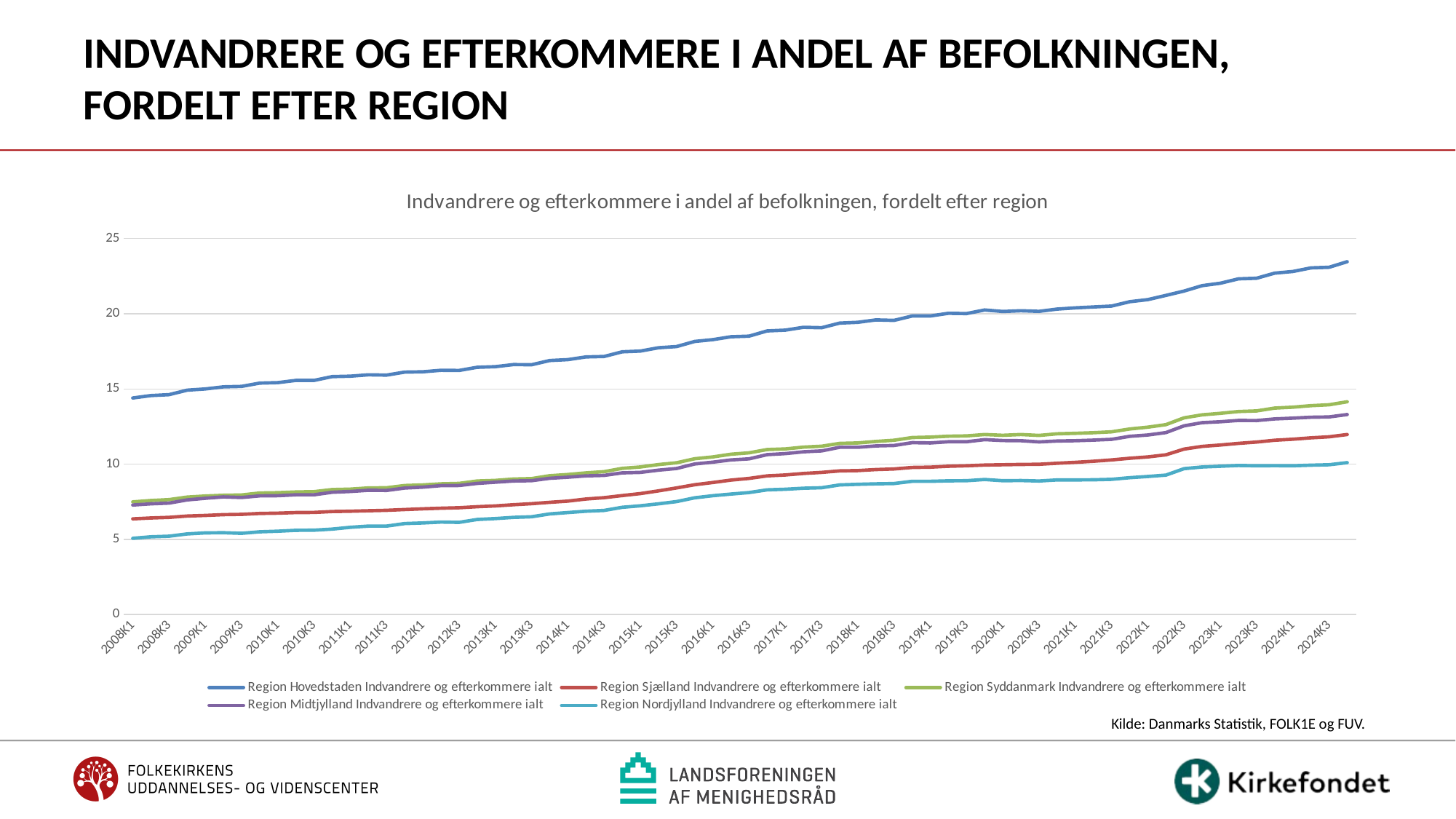
Do the values for Region Hovedstaden rise or fall from 2008K1 to 2024K3? rise What source is cited for the chart data? Danmarks Statistik, FOLK1E og FUV Which region has the lowest share of immigrants and descendants throughout the period? Region Nordjylland At 2024K3, which is larger: the value for Region Sjælland or Region Nordjylland? Region Sjælland What kind of chart is shown on the slide? line chart Which region has the highest share of immigrants and descendants throughout the period? Region Hovedstaden Is the value for Region Nordjylland at 2008K1 greater or less than 10? less Is the value for Region Hovedstaden at 2024K3 greater or less than 20? greater Is the value for Region Syddanmark at 2024K3 greater or less than 15? less How many series does the legend list? 5 At 2024K3, which is larger: the value for Region Syddanmark or Region Midtjylland? Region Syddanmark